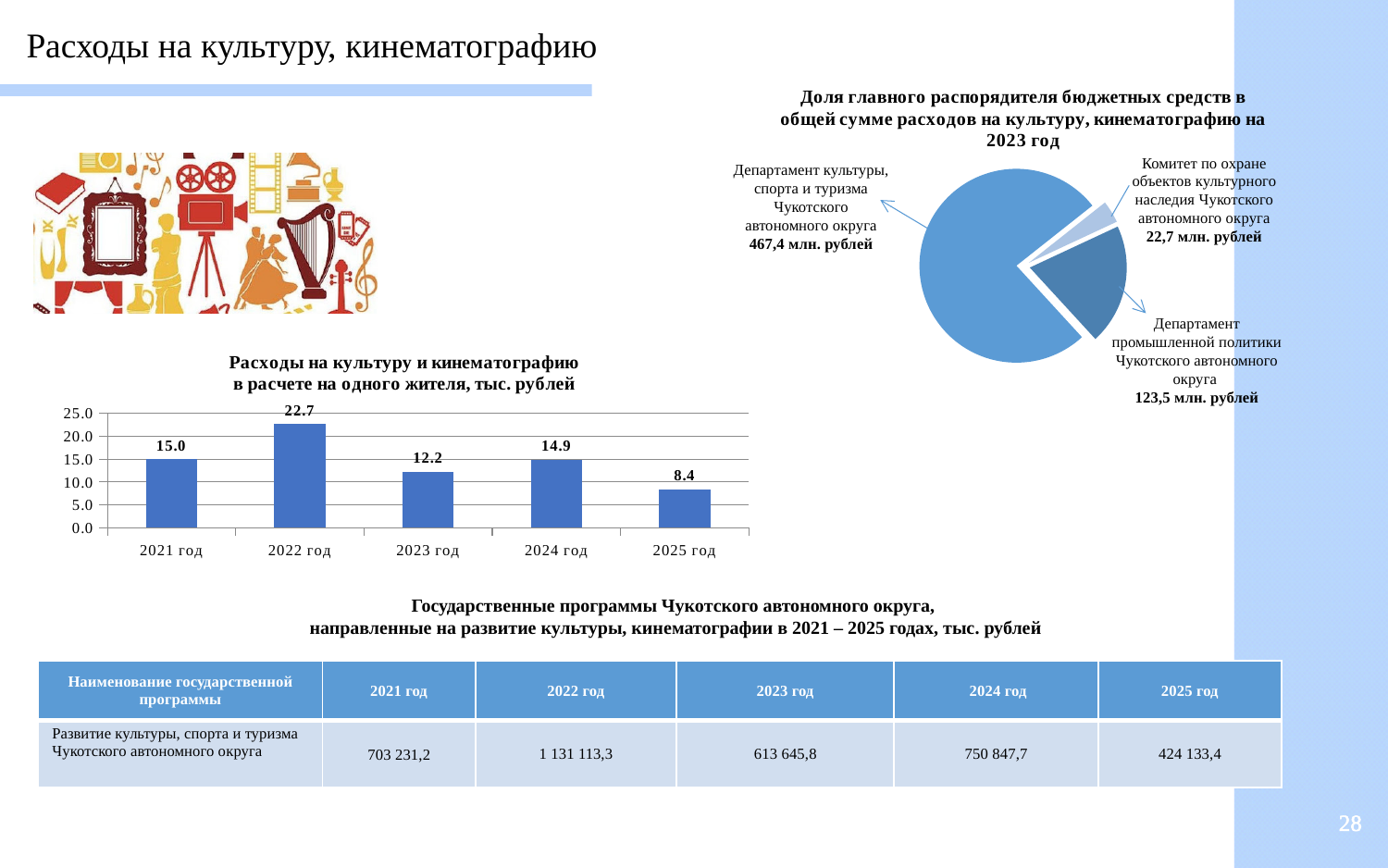
In the bar chart «Расходы на культуру и кинематографию в расчете на одного жителя», what is the value for 2025 год? 8.4 In the pie chart «Доля главного распорядителя бюджетных средств в общей сумме расходов на культуру, кинематографию на 2023 год», which slice is the largest? Департамент культуры, спорта и туризма Чукотского автономного округа In the pie chart «Доля главного распорядителя бюджетных средств в общей сумме расходов на культуру, кинематографию на 2023 год», how many slices are there? 3 In the bar chart «Расходы на культуру и кинематографию в расчете на одного жителя», how many years are shown on the x axis? 5 In the bar chart «Расходы на культуру и кинематографию в расчете на одного жителя», which year has the highest value? 2022 год In the bar chart «Расходы на культуру и кинематографию в расчете на одного жителя», what is the difference between the values for 2022 год and 2023 год? 10.5 In the bar chart «Расходы на культуру и кинематографию в расчете на одного жителя», which year has the lowest value? 2025 год In the pie chart «Доля главного распорядителя бюджетных средств в общей сумме расходов на культуру, кинематографию на 2023 год», what is the value for Департамент культуры, спорта и туризма Чукотского автономного округа? 467,4 млн. рублей What kind of chart is the chart titled «Расходы на культуру и кинематографию в расчете на одного жителя, тыс. рублей»? Bar chart In the pie chart «Доля главного распорядителя бюджетных средств в общей сумме расходов на культуру, кинематографию на 2023 год», what is the difference between the values for Департамент промышленной политики and Комитет по охране объектов культурного наследия? 100,8 млн. рублей In the bar chart «Расходы на культуру и кинематографию в расчете на одного жителя», what is the value for 2022 год? 22.7